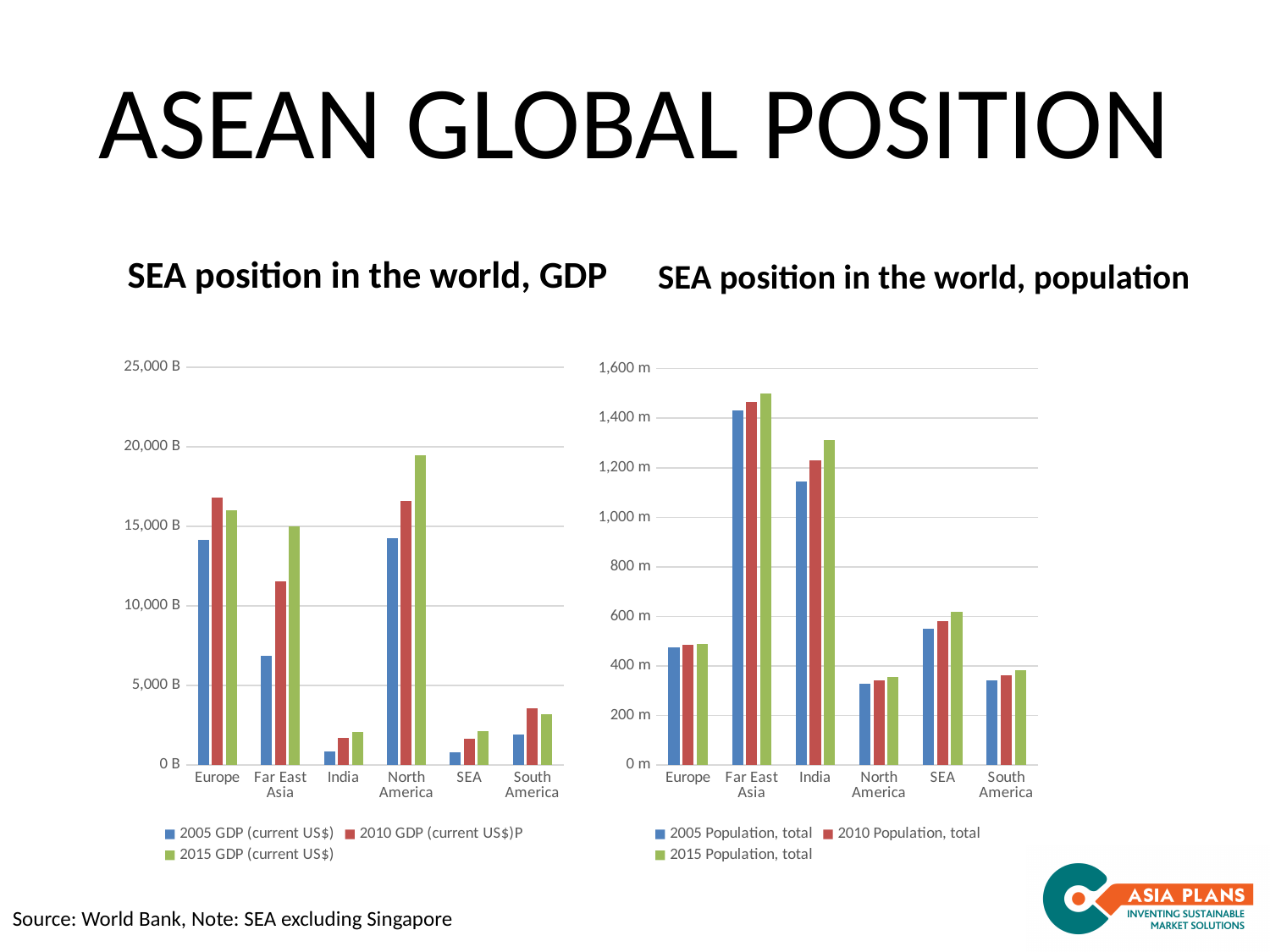
In the 'SEA position in the world, GDP' chart, which is larger: the 2010 GDP for Europe or the 2010 GDP for Far East Asia? Europe In the 'SEA position in the world, GDP' chart, does the GDP for Far East Asia rise or fall from 2005 to 2015? rise How many regions are shown on the x axis of the 'SEA position in the world, population' chart? 6 How many series does the legend of the 'SEA position in the world, GDP' chart list? 3 In the 'SEA position in the world, population' chart, which region has the highest 2015 population? Far East Asia In the 'SEA position in the world, population' chart, is the 2015 population for SEA greater or less than 400 m? greater In the 'SEA position in the world, GDP' chart, which region has the highest 2015 GDP? North America In the 'SEA position in the world, population' chart, which is larger: the 2015 population for India or the 2015 population for Far East Asia? Far East Asia In the 'SEA position in the world, population' chart, what colour represents the '2015 Population, total' series? green In the 'SEA position in the world, GDP' chart, is the 2015 GDP for Far East Asia greater or less than 10,000 B? greater What kind of chart is the 'SEA position in the world, GDP' chart? bar chart In the 'SEA position in the world, population' chart, is the 2015 population for India greater or less than 1,200 m? greater